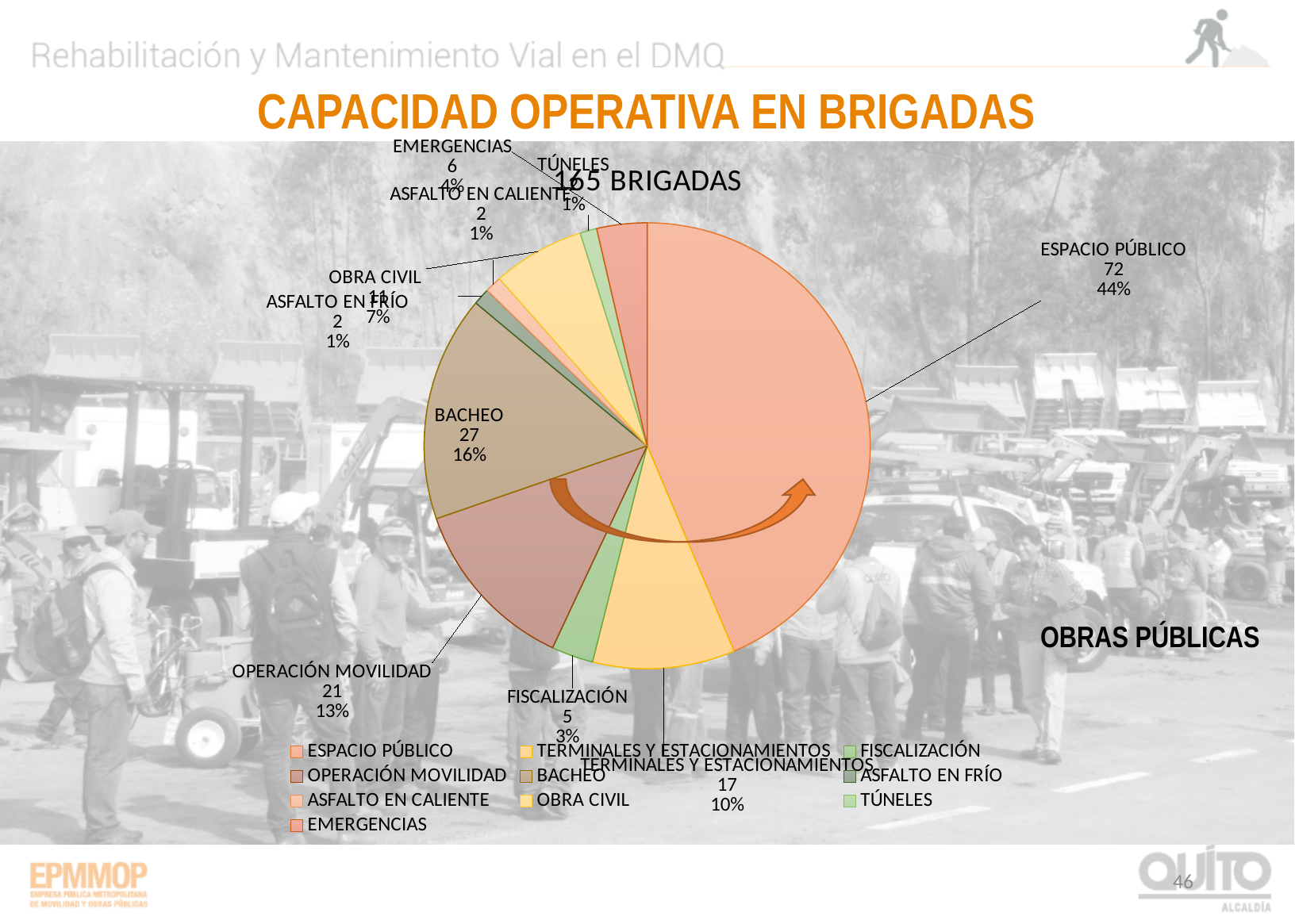
How many brigades does ESPACIO PÚBLICO account for in the pie chart? 72 What kind of chart is shown on the slide? pie chart What is the value shown for OPERACIÓN MOVILIDAD in the pie chart? 21 Which category has the largest slice of the pie chart? ESPACIO PÚBLICO What is the title shown above the pie chart? 165 BRIGADAS What is the value shown for EMERGENCIAS in the pie chart? 6 What is the difference between the values for ESPACIO PÚBLICO and BACHEO? 45 What percentage share of the pie chart does BACHEO have? 16% Which is larger in the pie chart, OPERACIÓN MOVILIDAD or OBRA CIVIL? OPERACIÓN MOVILIDAD How many categories does the legend of the pie chart list? 10 What percentage share does TERMINALES Y ESTACIONAMIENTOS have in the pie chart? 10% What percentage share does FISCALIZACIÓN have in the pie chart? 3%